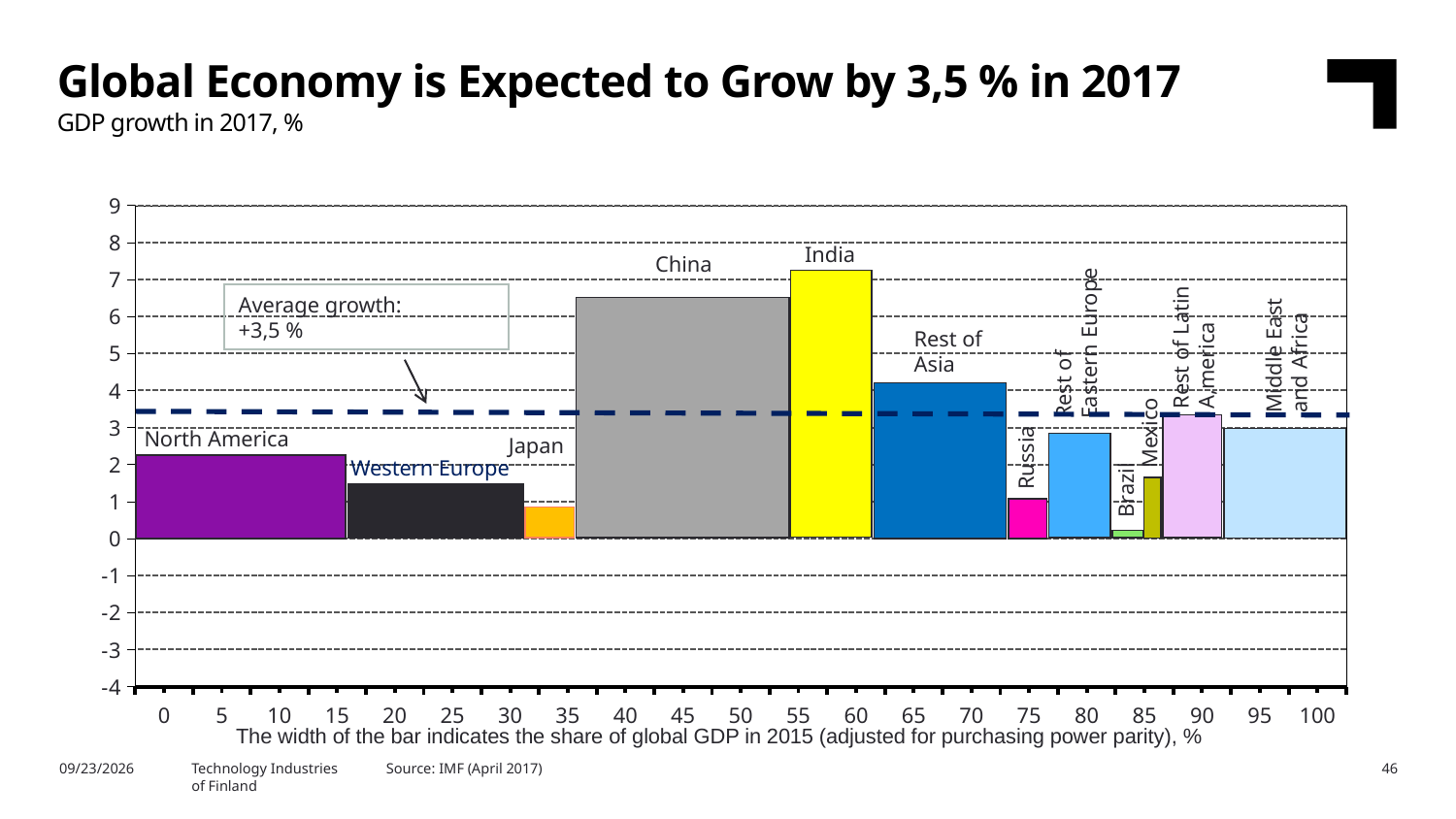
Is the GDP growth value for Rest of Asia greater or less than 4? greater Is the GDP growth value for North America greater or less than 2? greater Which has higher GDP growth in 2017, North America or Western Europe? North America According to the note below the x axis, what does the width of each bar indicate? The share of global GDP in 2015 (adjusted for purchasing power parity), % Is the GDP growth value for Japan greater or less than 1? less How many regions or countries are shown as bars in the chart? 12 What average growth value is printed in the annotation box on the chart? +3,5 % Which region or country has the lowest GDP growth in 2017? Brazil Which region or country has the highest GDP growth in 2017? India Which has higher GDP growth in 2017, China or India? India What kind of chart is shown on the slide? bar chart